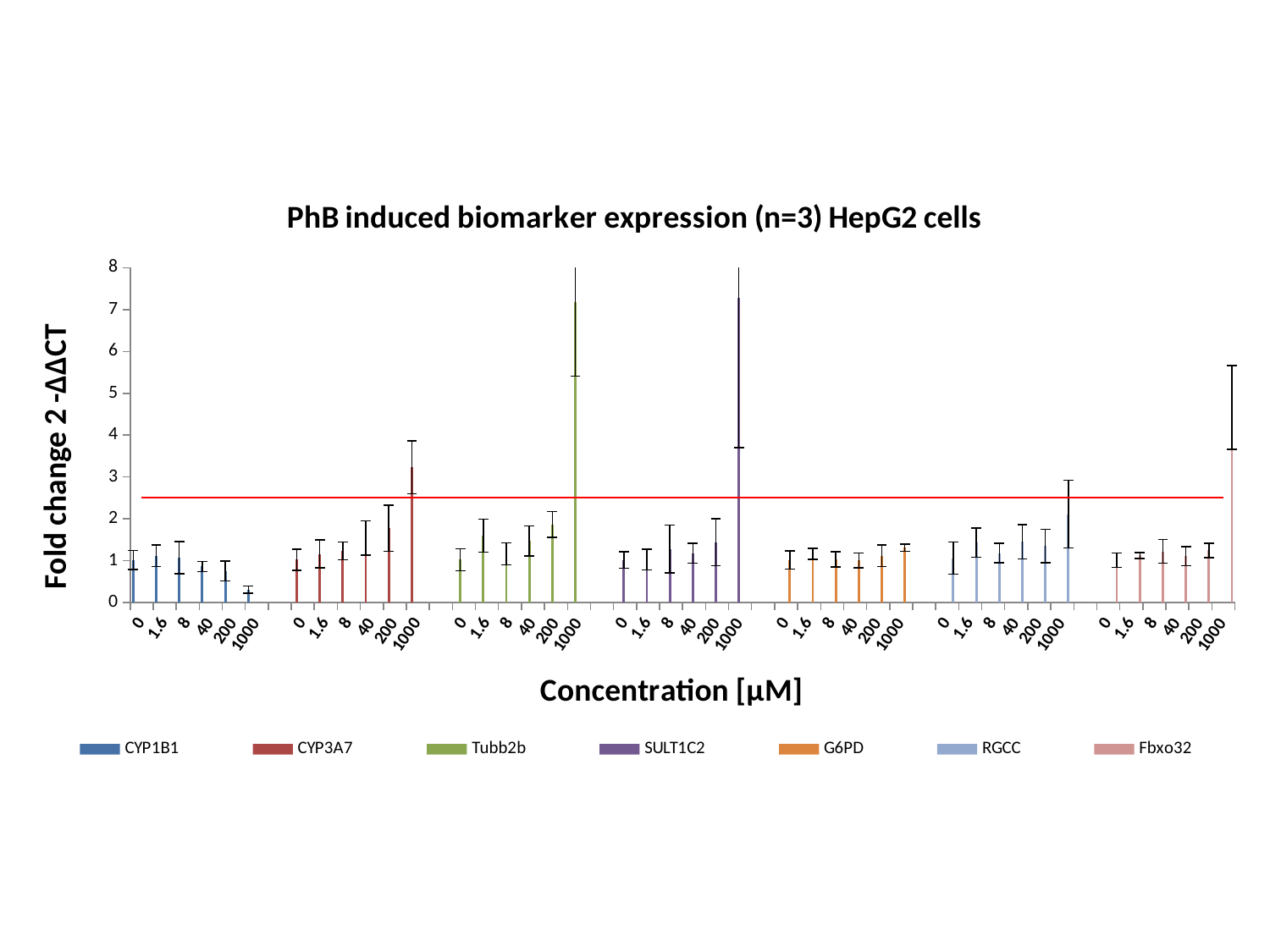
What kind of chart is shown on the slide? Bar chart How many concentration levels are plotted for each series? 6 Is the value for CYP1B1 at 1000 µM greater or less than 1? less How many series does the legend list? 7 Is the value for Fbxo32 at 1000 µM greater or less than 3? greater What is the title of the chart? PhB induced biomarker expression (n=3) HepG2 cells At 1000 µM, which is larger: the value for CYP3A7 or the value for CYP1B1? CYP3A7 At 1000 µM, which is larger: the value for Fbxo32 or the value for RGCC? Fbxo32 Is the value for Tubb2b at 1000 µM greater or less than 6? greater What is the label of the x axis? Concentration [µM]